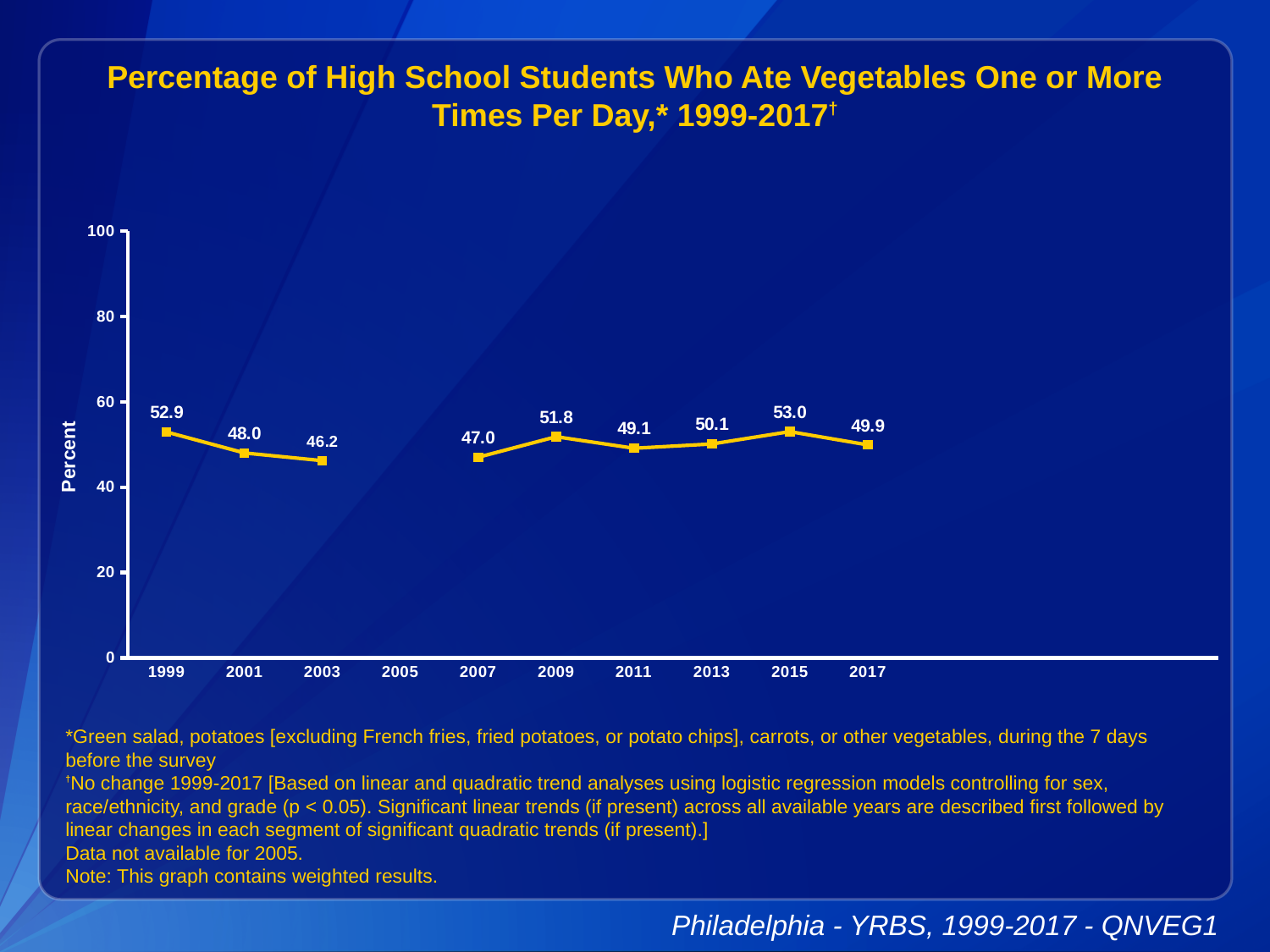
What was the percentage of high school students who ate vegetables one or more times per day in 1999? 52.9 What kind of chart is shown on the slide? line chart What value is shown for 2015? 53.0 Do the values rise or fall from 1999 to 2003? fall Which is larger, the value for 2009 or the value for 2011? 2009 What value is shown for 2007? 47.0 What is the difference between the 1999 value and the 2003 value? 6.7 How many data points are plotted on the chart? 9 Is the value for 2013 greater or less than 60? less What value is shown for 2017? 49.9 What is the difference between the 2015 value and the 2007 value? 6.0 Which year has the lowest plotted value? 2003